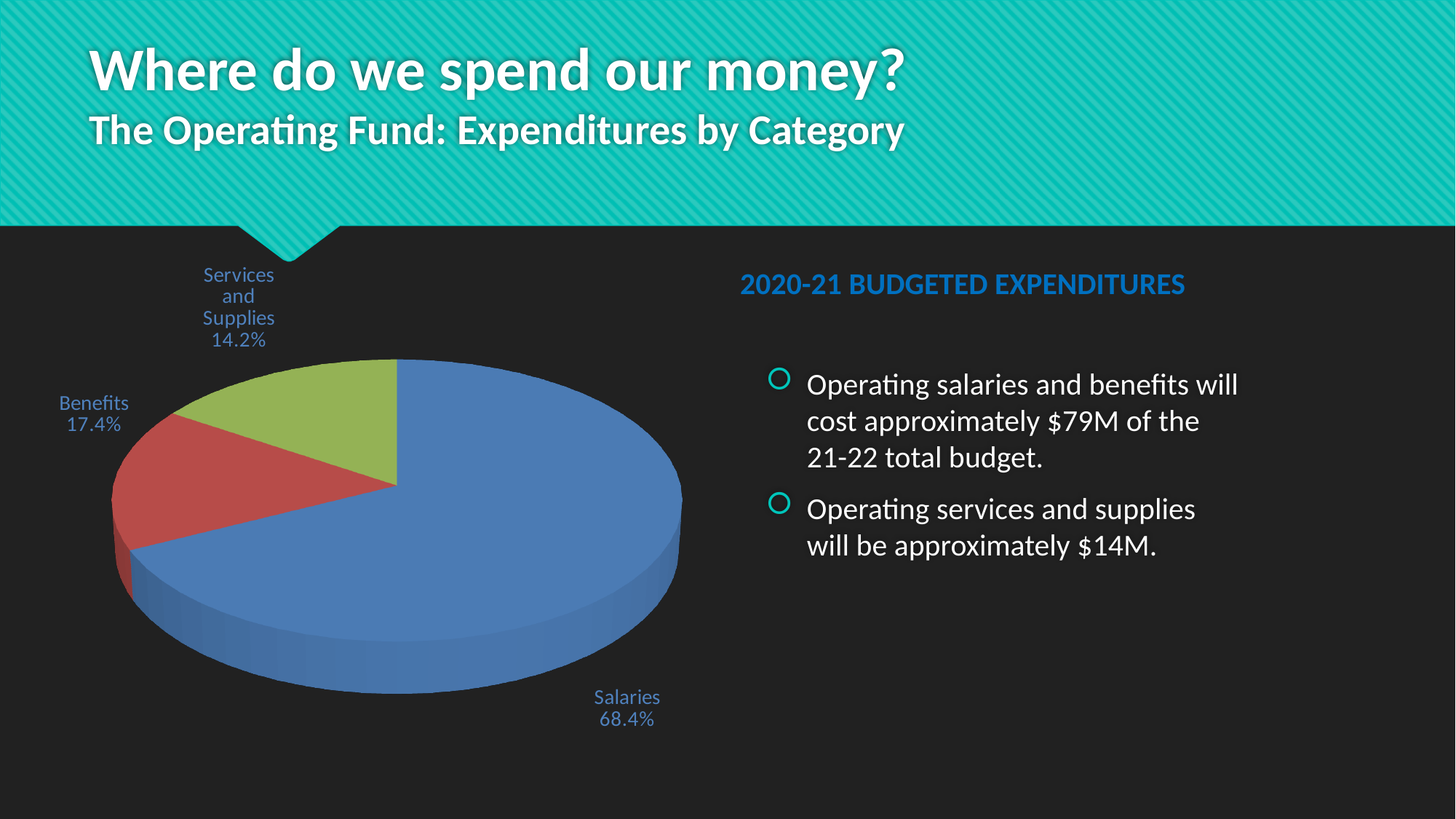
What share of the pie does Benefits represent? 17.4% Which category has the largest slice of the pie? Salaries How many categories are shown in the pie chart? 3 What colour is the Salaries slice? Blue What kind of chart is shown on the slide? Pie chart What share of the pie does Salaries represent? 68.4% Which category has the smallest slice of the pie? Services and Supplies What share of the pie does Services and Supplies represent? 14.2% What is the difference in percentage points between the Benefits slice and the Services and Supplies slice? 3.2 percentage points What is the heading shown to the right of the pie chart? 2020-21 BUDGETED EXPENDITURES Which is larger, the Benefits slice or the Services and Supplies slice? Benefits What is the difference in percentage points between the Salaries slice and the Benefits slice? 51.0 percentage points